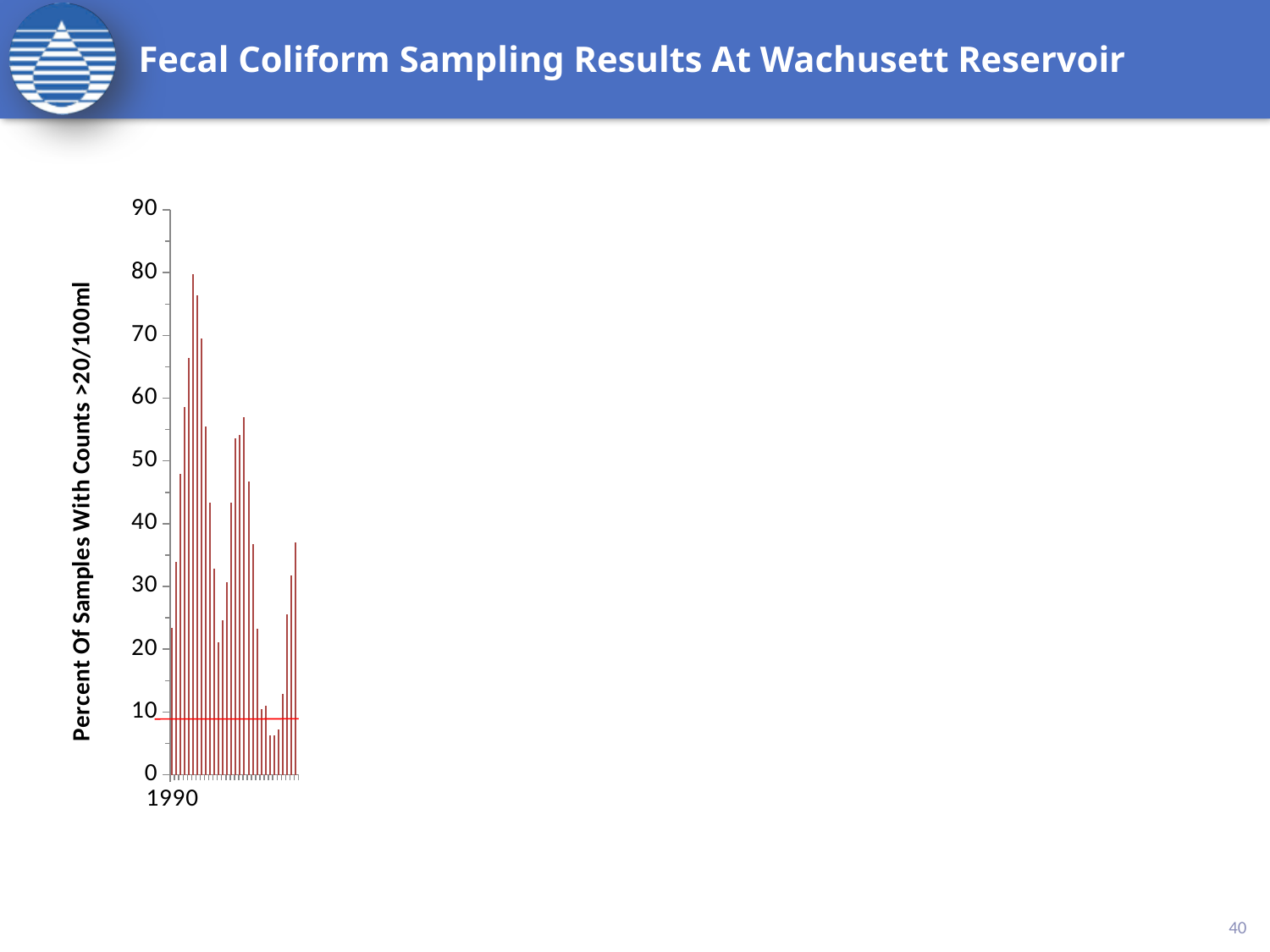
Is the horizontal red reference line in the chart drawn at a value greater or less than 20? less What is the highest value shown on the vertical axis of the chart? 90 Is the value of the tallest bar in the chart greater or less than 70? greater Is the value of the tallest bar in the chart greater or less than 90? less What is the first year label shown on the horizontal axis of the chart? 1990 What is the label on the vertical axis of the chart? Percent Of Samples With Counts >20/100ml What kind of chart is shown on the slide? bar chart